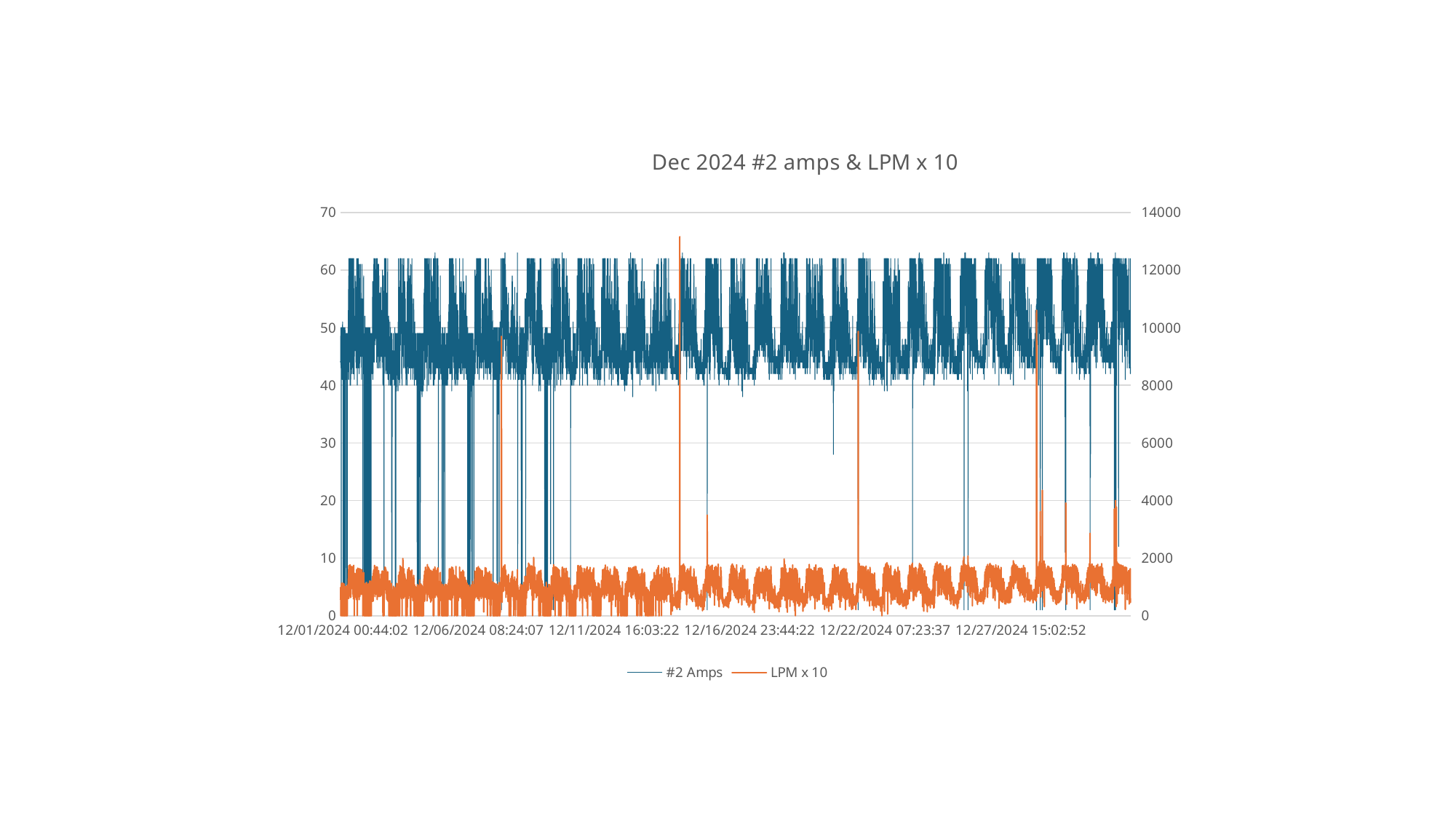
Which series is drawn in orange? LPM x 10 Is the typical level of the #2 Amps series greater or less than 30 on the left axis? greater Is the typical level of the LPM x 10 series greater or less than 4000 on the right axis? less Is the highest value of the #2 Amps series greater or less than 70 on the left axis? less What kind of chart is shown on the slide? line chart What is the title of the chart? Dec 2024 #2 amps & LPM x 10 How many series does the legend list? 2